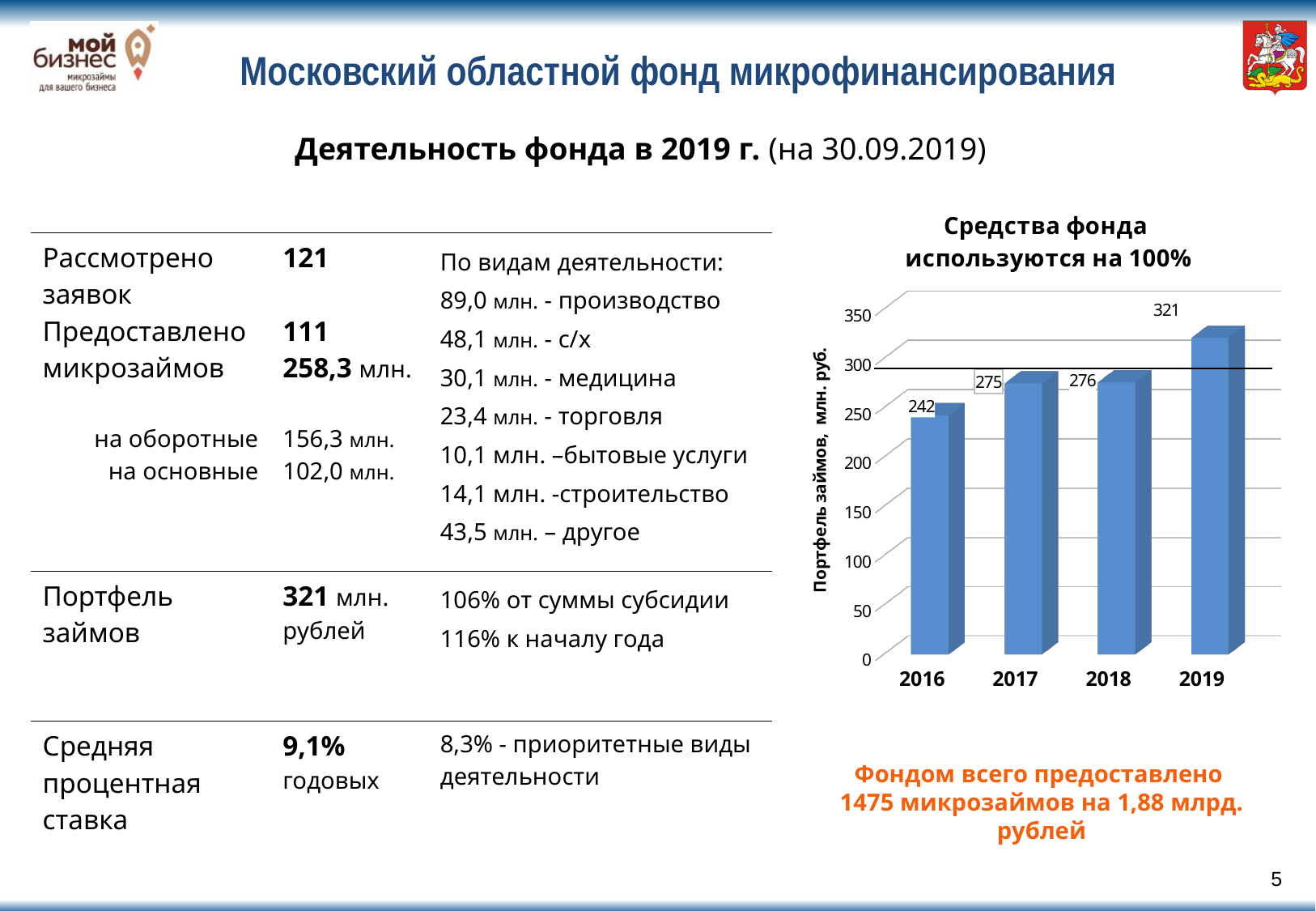
How many years are shown on the x axis of the chart? 4 What is the loan portfolio value for 2018 in the chart? 276 Do the values in the chart rise or fall from 2016 to 2019? rise What type of chart is shown on the slide? bar chart Which year has the highest loan portfolio value in the chart? 2019 Which year has the lowest loan portfolio value in the chart? 2016 What is the loan portfolio value for 2017 in the chart? 275 What is the loan portfolio value for 2019 in the chart? 321 What is the loan portfolio value for 2016 in the chart? 242 Which is larger in the chart: the value for 2019 or the value for 2017? 2019 What is the difference between the loan portfolio values for 2019 and 2016? 79 What is the title of the chart? Средства фонда используются на 100%